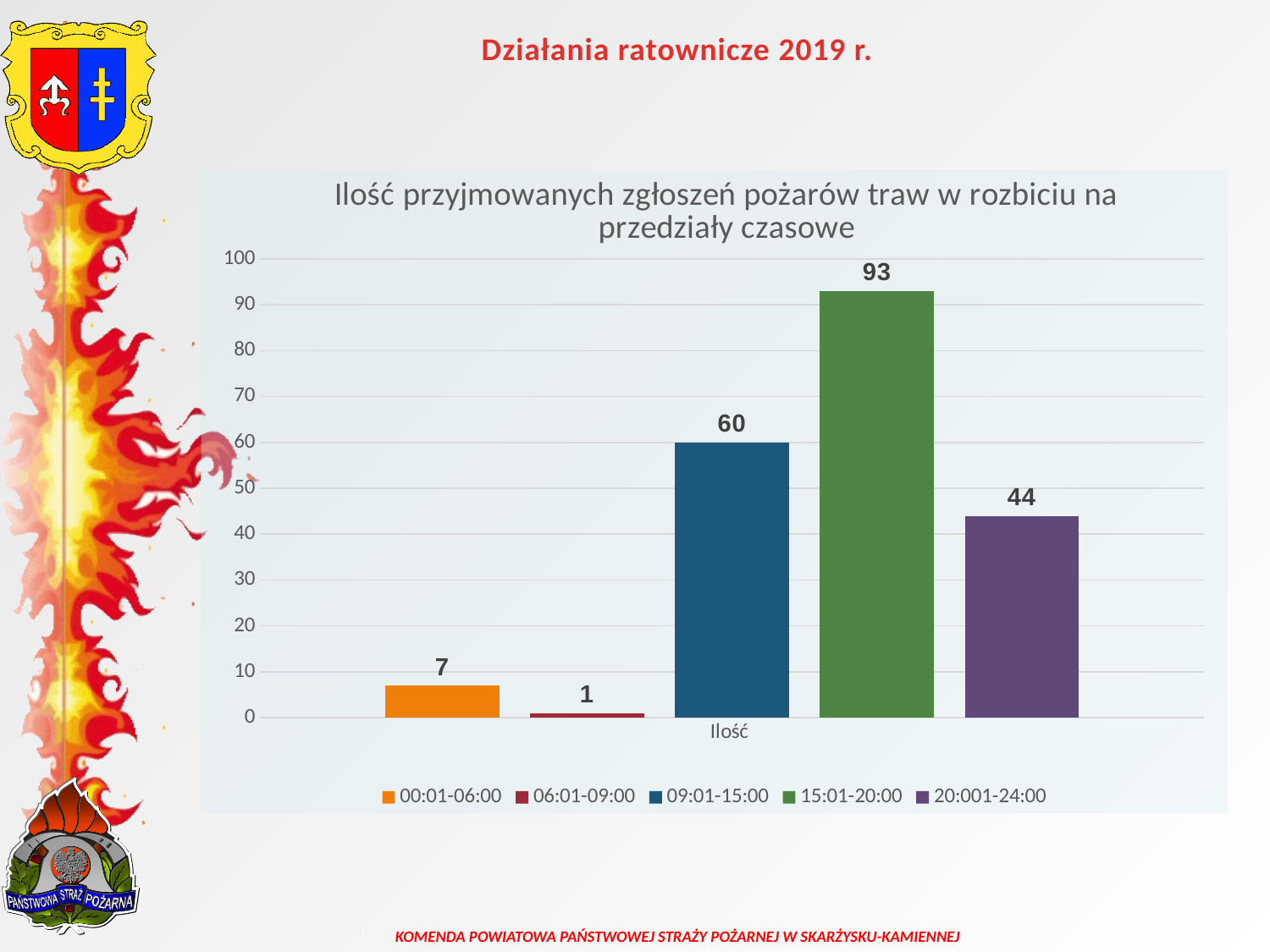
Is the value for 15:01-20:00 greater or less than 90? greater What is the value for the 00:01-06:00 series? 7 Which time interval has the lowest number of reports? 06:01-09:00 What is the difference between the values for 20:001-24:00 and 00:01-06:00? 37 What is the value for the 20:001-24:00 series? 44 Which is larger, the value for 09:01-15:00 or the value for 20:001-24:00? 09:01-15:00 Which time interval has the highest number of reports? 15:01-20:00 What is the value for the 09:01-15:00 series? 60 What is the difference between the values for 15:01-20:00 and 09:01-15:00? 33 What kind of chart is shown on the slide? bar chart How many series does the legend list? 5 What is the title of the chart? Ilość przyjmowanych zgłoszeń pożarów traw w rozbiciu na przedziały czasowe